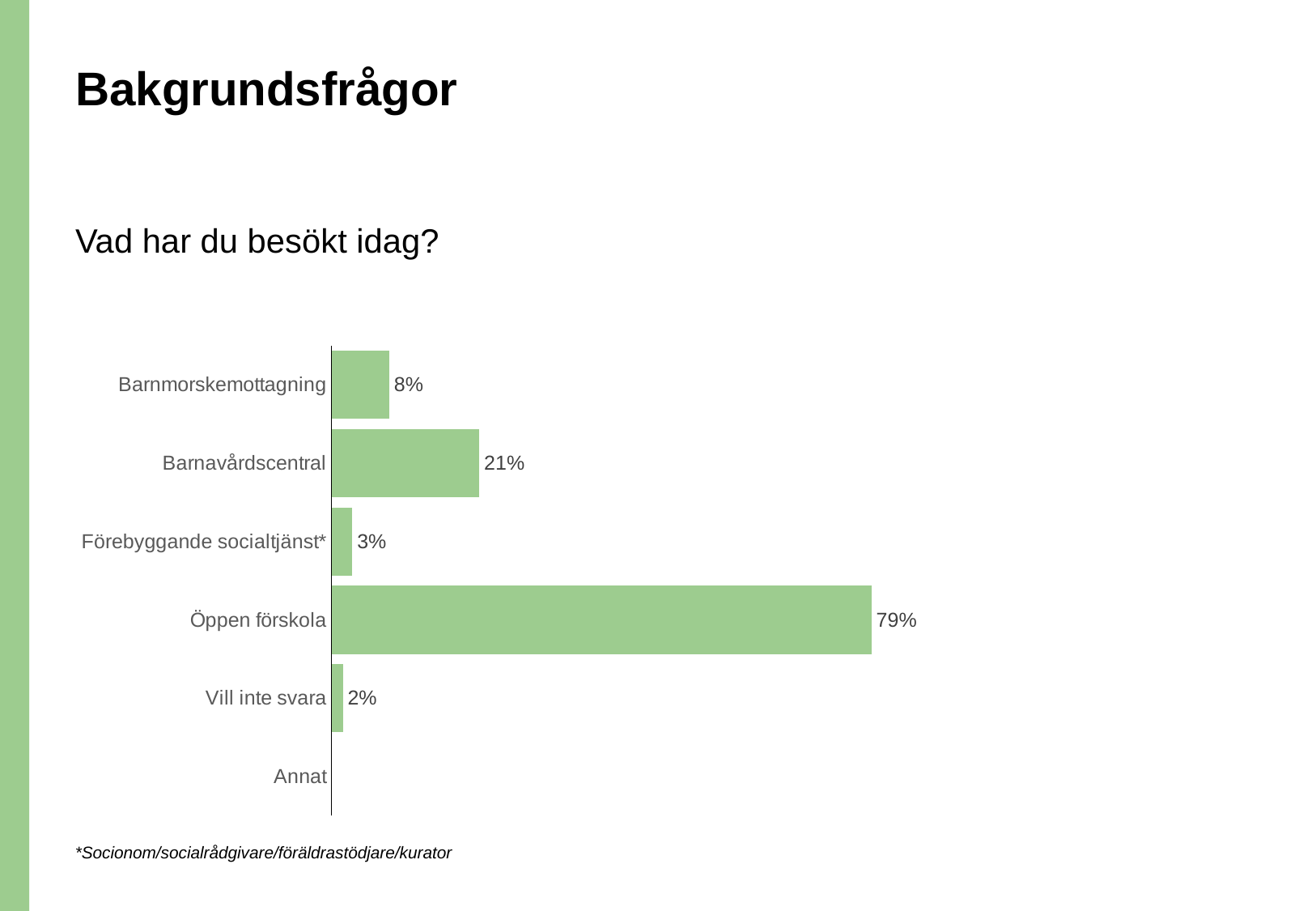
What is the value for Öppen förskola? 79% What kind of chart is shown on the slide? Bar chart Which is larger, the value for Barnmorskemottagning or the value for Förebyggande socialtjänst*? Barnmorskemottagning What question does the chart answer, as written above it? Vad har du besökt idag? What is the value for Barnmorskemottagning? 8% What is the difference between the values for Öppen förskola and Barnavårdscentral? 58% Which category with a labelled bar has the lowest value? Vill inte svara What is the value for Barnavårdscentral? 21% How many categories are listed on the chart? 6 Which category has the highest value? Öppen förskola What is the value for Vill inte svara? 2% What is the value for Förebyggande socialtjänst*? 3%